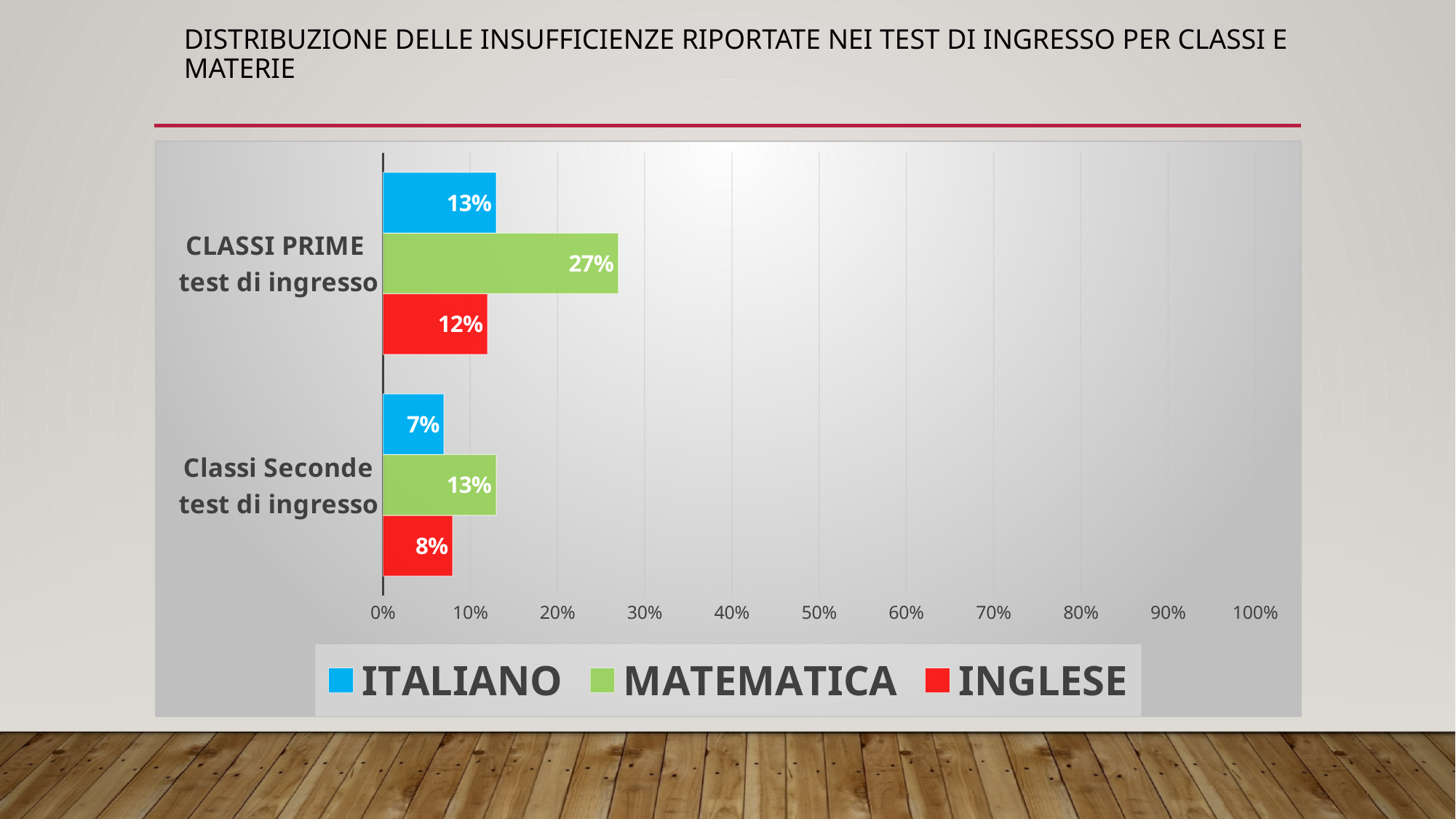
What is the value for INGLESE in Classi Seconde test di ingresso? 8% How many series does the legend list? 3 What is the difference between the MATEMATICA values for CLASSI PRIME and Classi Seconde? 14% Which subject has the lowest value in Classi Seconde test di ingresso? ITALIANO Which colour represents INGLESE in the chart? Red Which subject has the highest value in CLASSI PRIME test di ingresso? MATEMATICA Which is larger: ITALIANO in CLASSI PRIME or ITALIANO in Classi Seconde? ITALIANO in CLASSI PRIME What is the value for ITALIANO in Classi Seconde test di ingresso? 7% Is the value for MATEMATICA in CLASSI PRIME greater or less than 20%? greater What is the value for INGLESE in CLASSI PRIME test di ingresso? 12% What kind of chart is shown on the slide? Bar chart What is the value for MATEMATICA in CLASSI PRIME test di ingresso? 27%